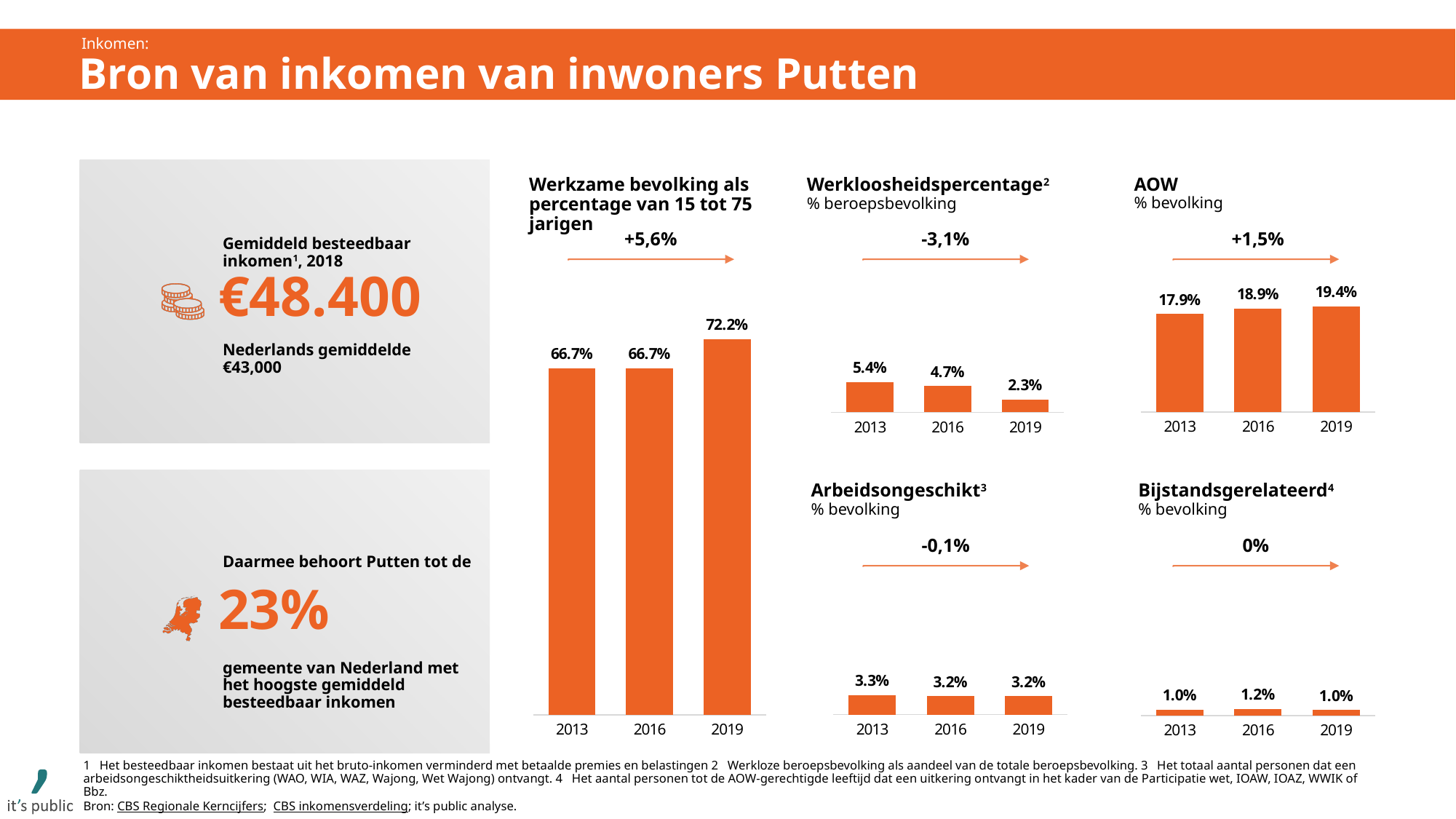
In the 'Werkzame bevolking als percentage van 15 tot 75 jarigen' chart, what is the value for 2019? 72.2% How many years are shown in the 'Arbeidsongeschikt' chart? 3 In the 'AOW' chart, what is the value for 2016? 18.9% In the 'Werkloosheidspercentage' chart, what is the value for 2013? 5.4% In the 'AOW' chart, which year has the highest value? 2019 In the 'Werkloosheidspercentage' chart, which year has the lowest value? 2019 In the 'Werkloosheidspercentage' chart, what is the difference between the 2013 and 2019 values? 3.1% In the 'AOW' chart, what is the difference between the 2019 and 2013 values? 1.5% In the 'Werkloosheidspercentage' chart, do the values rise or fall from 2013 to 2019? fall What kind of chart is the 'AOW' chart? bar chart In the 'Arbeidsongeschikt' chart, what is the value for 2013? 3.3% In the 'Bijstandsgerelateerd' chart, what is the value for 2016? 1.2%